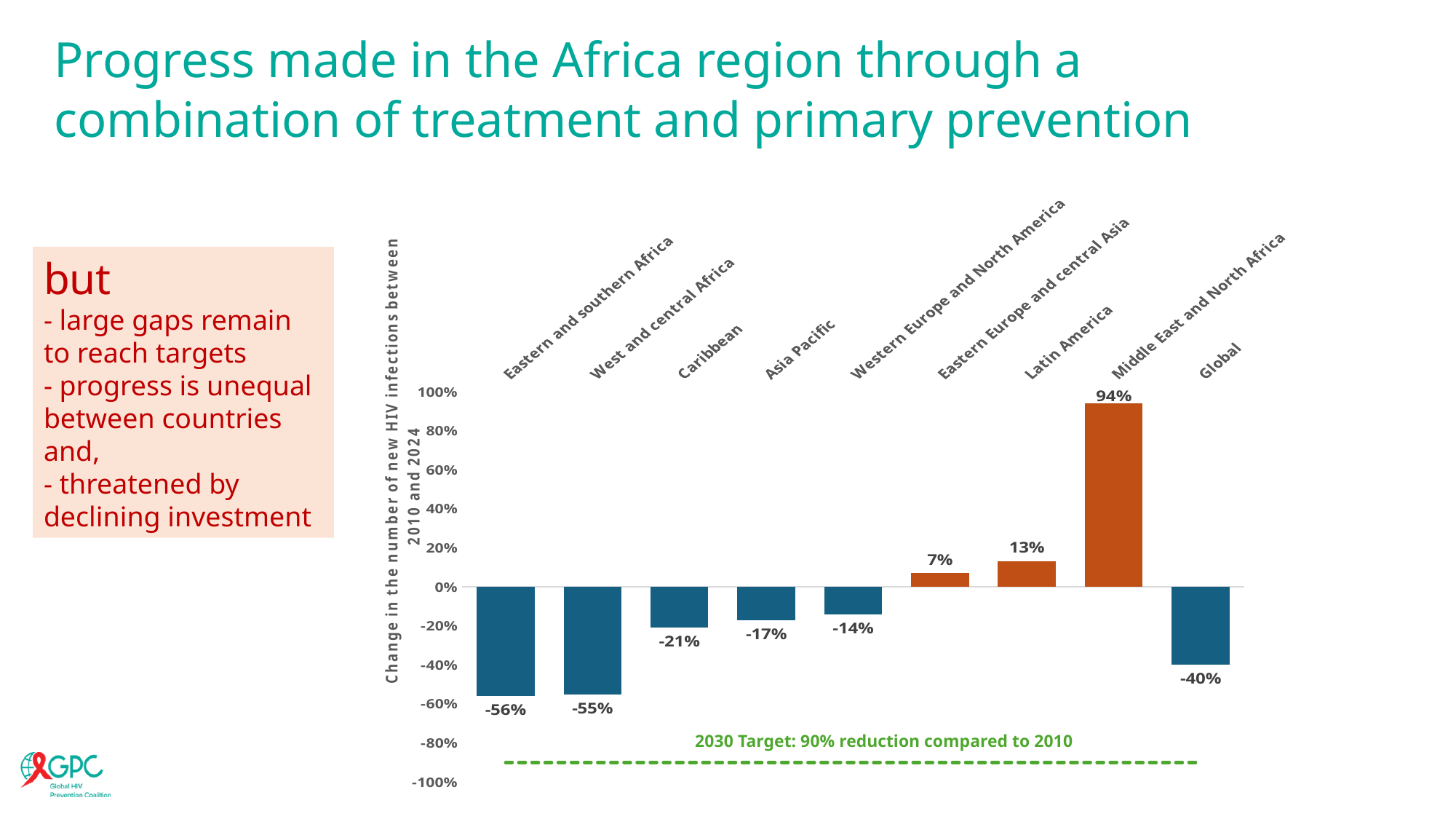
What is the value for Latin America? 13% What is the Global change in the number of new HIV infections between 2010 and 2024? -40% Is the value for West and central Africa greater or less than -40%? less What is the value shown for Middle East and North Africa? 94% Which region has the lowest value on the chart? Eastern and southern Africa Which region has the highest value on the chart? Middle East and North Africa What does the green dashed line on the chart represent? 2030 Target: 90% reduction compared to 2010 What is the change in new HIV infections for Eastern and southern Africa? -56% What kind of chart is shown on the slide? Bar chart Which has a larger value, Western Europe and North America or Latin America? Latin America What is the difference between the values for Caribbean and Asia Pacific? 4 percentage points How many categories are plotted on the chart? 9